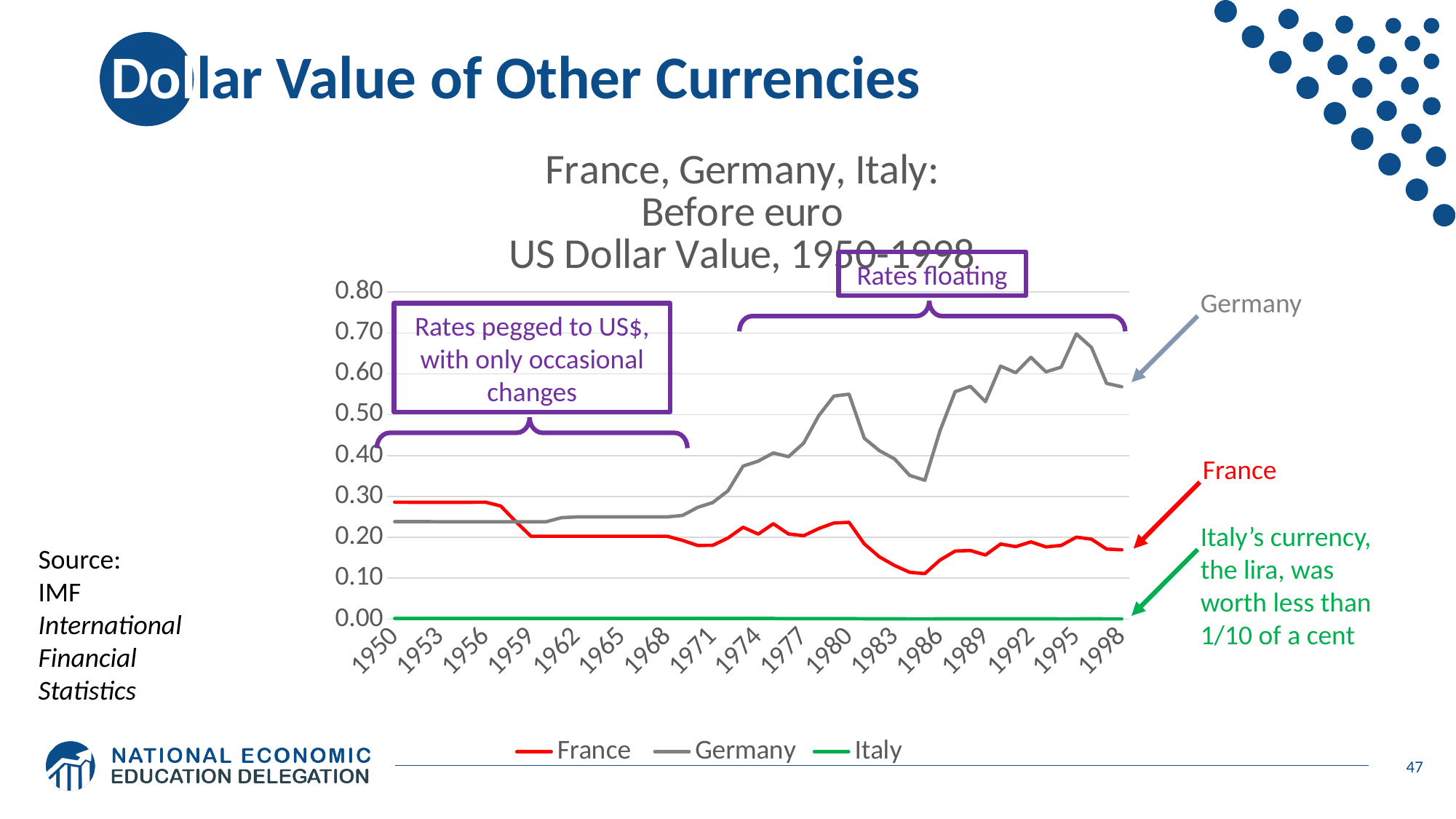
How many year labels are shown on the x axis? 17 Is the value for Italy in 1998 greater or less than 0.10? less What is the title of the chart? France, Germany, Italy: Before euro US Dollar Value, 1950-1998 How many series does the legend list? 3 Does the Germany line generally rise or fall from 1950 to 1998? Rise Which series has the highest value in 1998, France or Germany? Germany Is the value for Germany in 1995 greater or less than 0.60? greater Is the value for France in 1986 greater or less than 0.20? less What type of chart is shown on the slide? Line chart Which series has the lowest values across the whole period? Italy Which currencies are listed in the chart legend? France, Germany, Italy